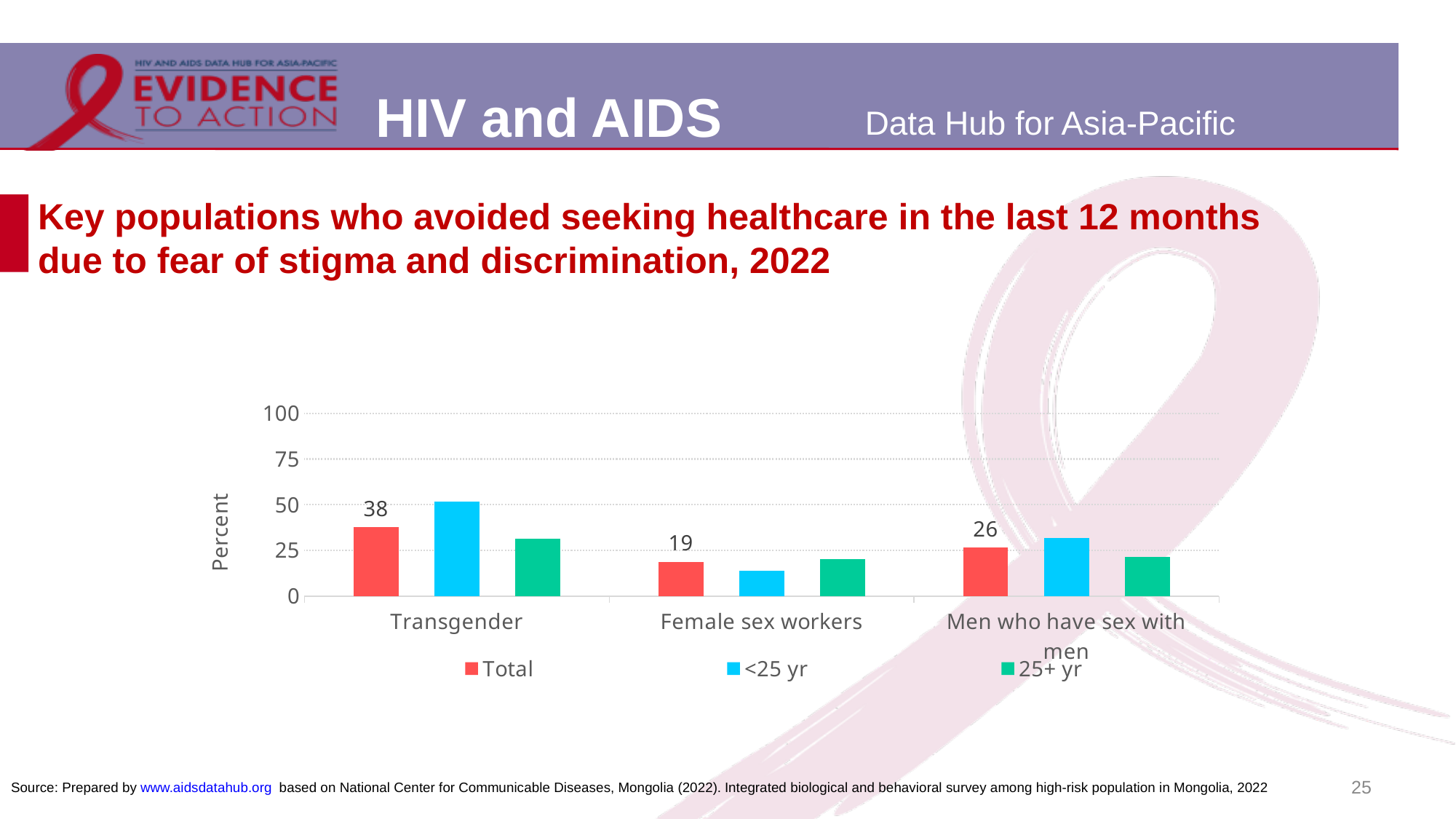
Which key population has the lowest Total value? Female sex workers What is the Total value for Men who have sex with men? 26 How many key population categories are shown on the x axis? 3 What is the difference between the Total values for Transgender and Female sex workers? 19 What kind of chart is shown on the slide? Bar chart Which key population has the highest Total value? Transgender What is the Total value for Transgender? 38 Is the <25 yr value for Female sex workers greater or less than 25? less What is the Total value for Female sex workers? 19 Is the <25 yr value for Transgender greater or less than 25? greater How many series does the legend list? 3 Which is larger, the Total value for Men who have sex with men or for Female sex workers? Men who have sex with men